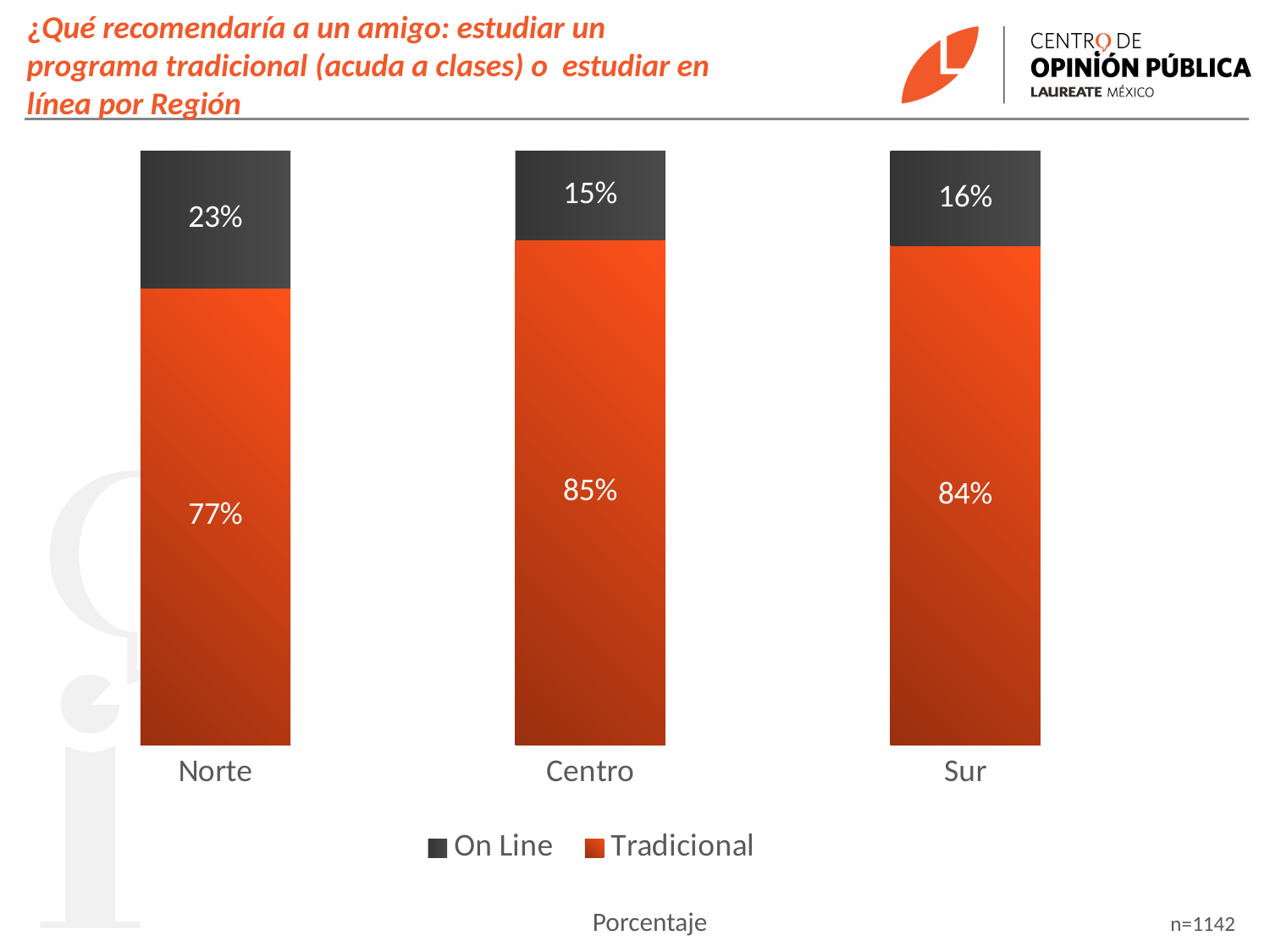
What is the Tradicional value for Norte? 77% What is the On Line value for Sur? 16% Which region has the highest On Line value? Norte How many regions are shown on the x axis? 3 Which region has the lowest Tradicional value? Norte What is the total of the stacked bar for Sur? 100% Which is larger, the On Line value for Norte or the On Line value for Sur? Norte What is the Tradicional value for Centro? 85% What is the On Line value for Centro? 15% What kind of chart is shown on the slide? Stacked bar chart What is the difference between the Tradicional and On Line values for Norte? 54% How many series does the legend list? 2